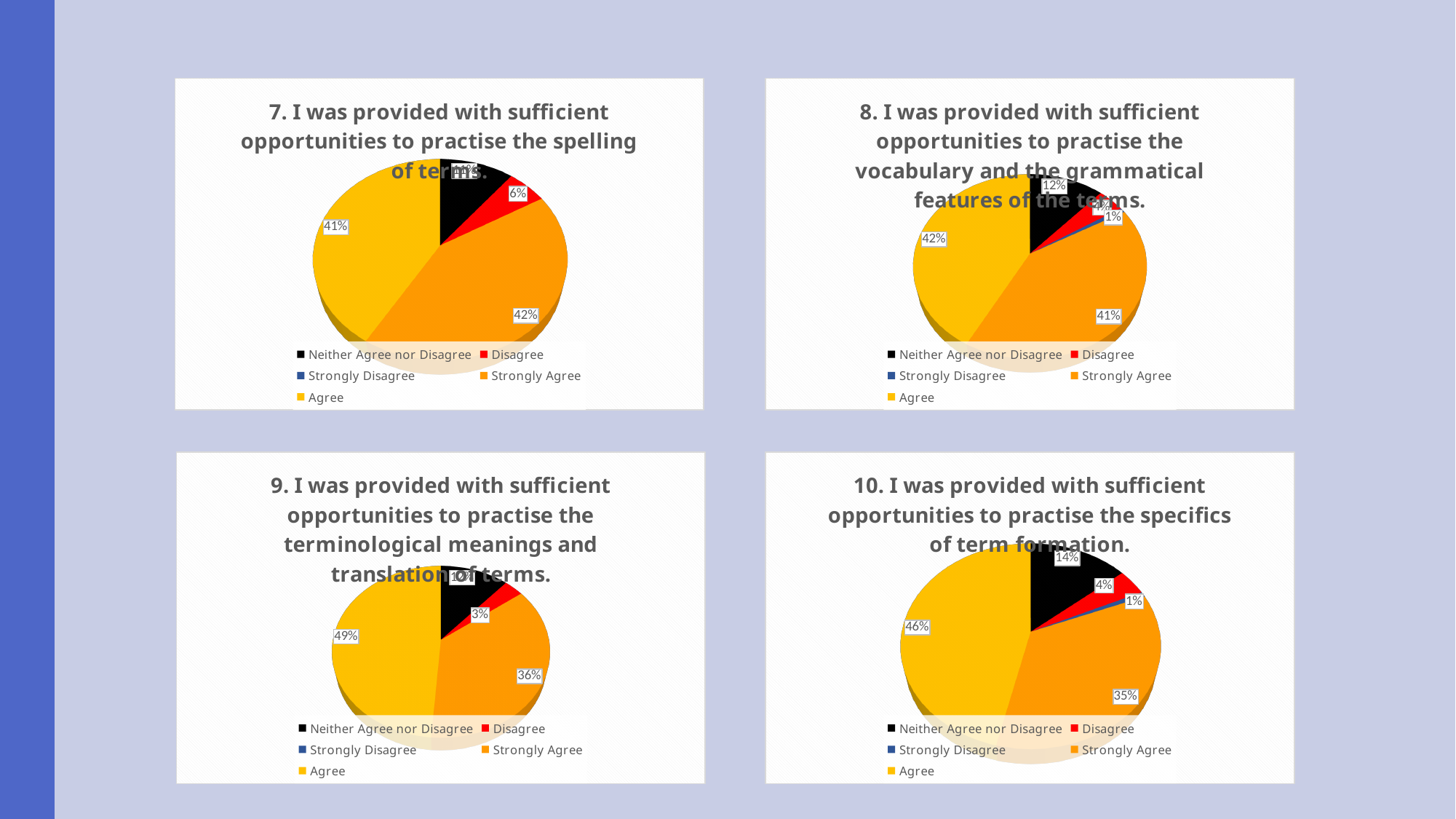
In the chart for question 9 (terminological meanings and translation of terms), what percentage is shown for Strongly Agree? 36% In the chart for question 10 (specifics of term formation), what percentage is shown for Strongly Disagree? 1% In the chart for question 10 (specifics of term formation), which category has the smallest slice? Strongly Disagree In the chart for question 10 (specifics of term formation), what is the difference in percentage points between Agree and Strongly Agree? 11 percentage points How many entries does the legend of the chart for question 10 list? 5 In the chart for question 9 (terminological meanings and translation of terms), which category has the largest slice? Agree In the top-left chart (question 7), which is larger, the Strongly Agree slice or the Agree slice? Strongly Agree In the chart for question 8 (vocabulary and grammatical features of terms), what share of responses is Agree? 42% In the chart titled "7. I was provided with sufficient opportunities to practise the spelling of terms.", what share of responses is Agree? 41% In the chart for question 8 (vocabulary and grammatical features of terms), what percentage is shown for Neither Agree nor Disagree? 12% What type of chart is used for question 7 in the top-left of the slide? Pie chart In the chart titled "7. I was provided with sufficient opportunities to practise the spelling of terms.", what percentage is shown for Disagree? 6%